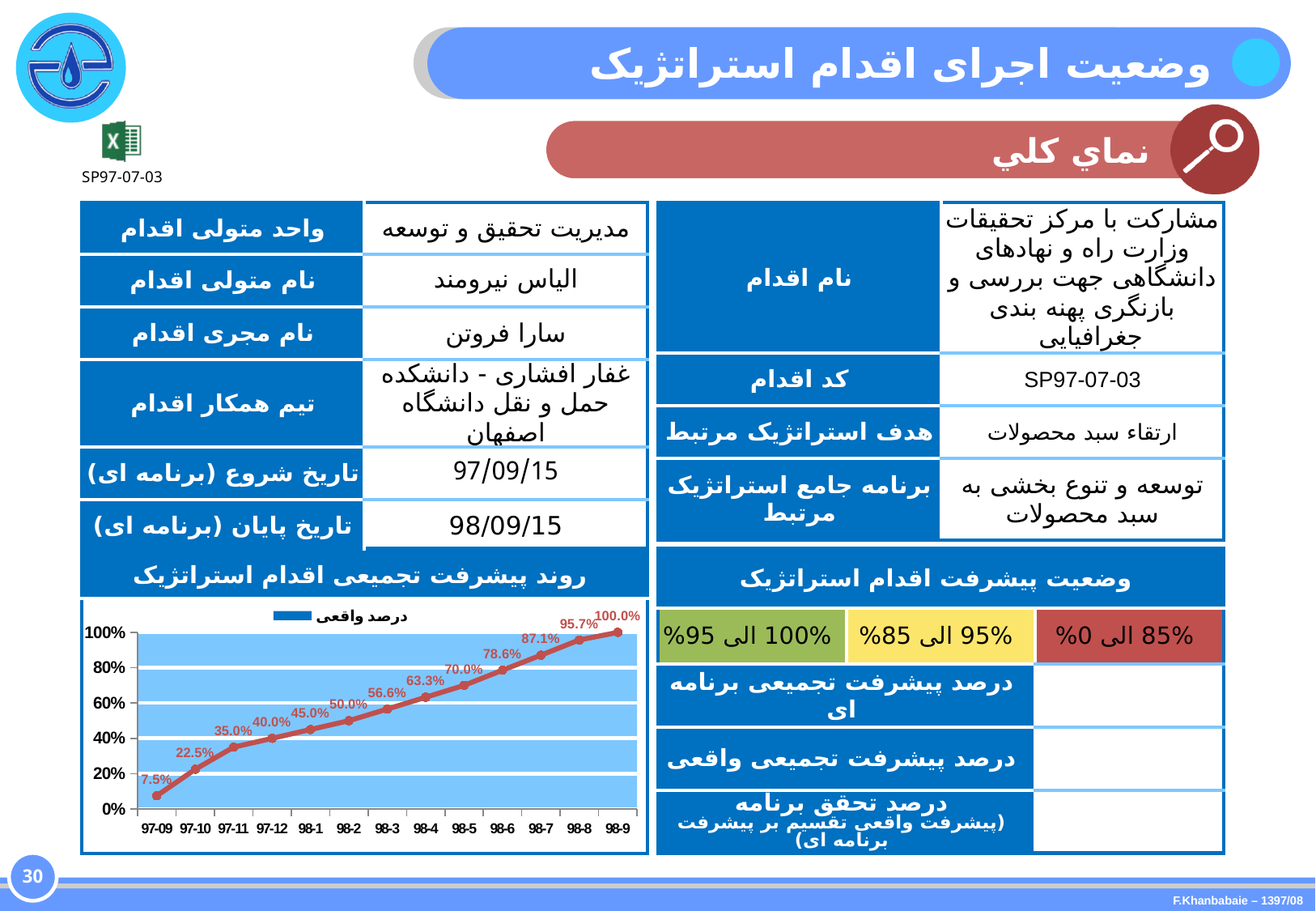
What type of chart is shown on the slide? line chart How many series does the legend of the line chart list? 1 What is the value for 98-7 in the line chart? 87.1% What is the value for 97-09 in the line chart? 7.5% Which category has the highest value in the line chart? 98-9 What is the difference between the values for 97-10 and 97-09? 15.0% What is the value for 98-3 in the line chart? 56.6% Which is larger, the value for 98-1 or the value for 98-5? 98-5 How many data points are plotted in the line chart? 13 What is the difference between the values for 98-9 and 98-8? 4.3% Do the values in the line chart rise or fall from 97-09 to 98-9? rise Which category has the lowest value in the line chart? 97-09